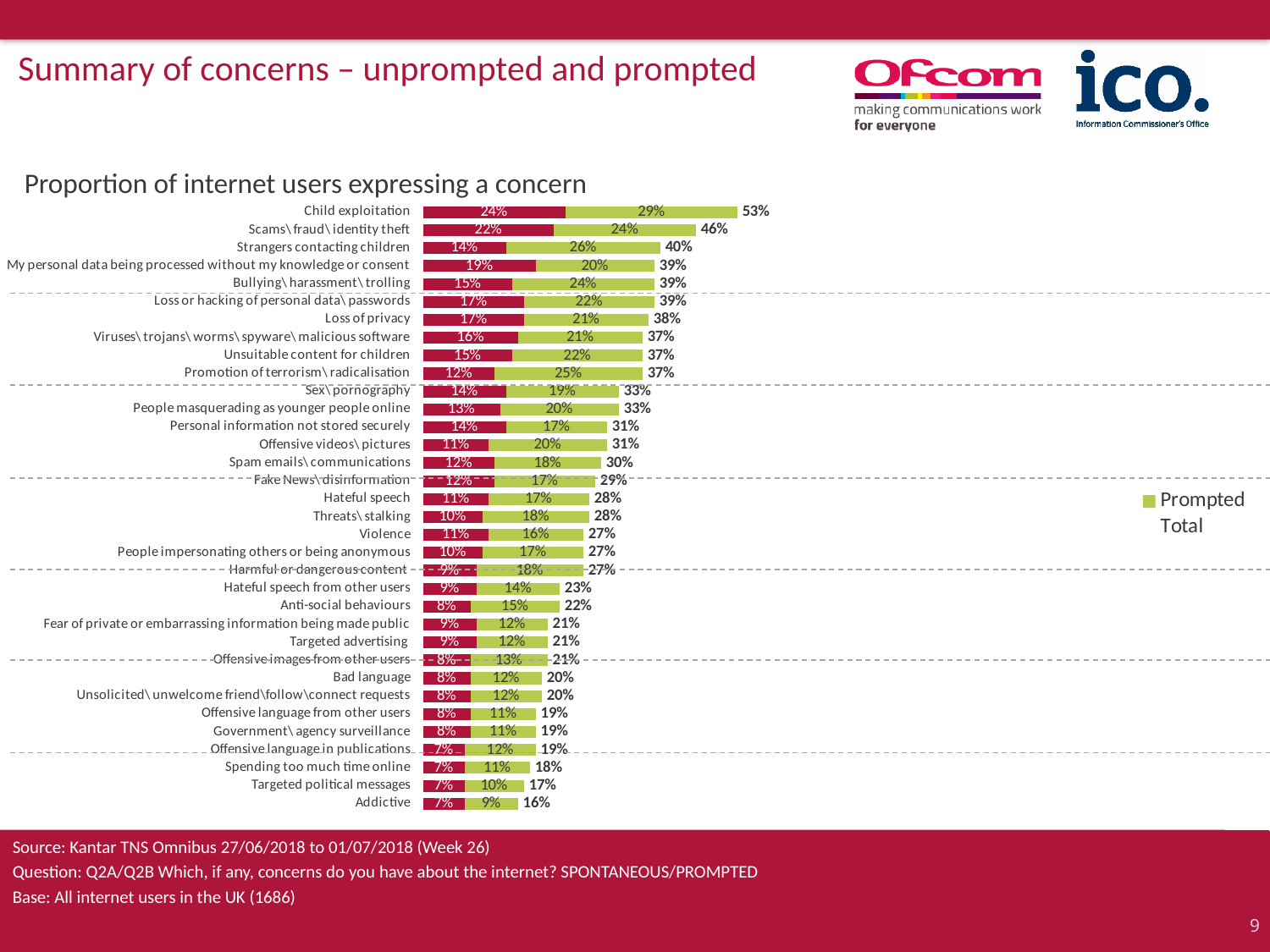
Which concern has the highest total proportion of internet users expressing it? Child exploitation What is the title of the chart? Proportion of internet users expressing a concern Which concern has the lowest total proportion of internet users expressing it? Addictive What is the value of the red (unprompted) segment for Child exploitation? 24% What is the Prompted (green) value for Strangers contacting children? 26% What is the total percentage for Scams\fraud\identity theft? 46% What is the total percentage for Targeted political messages? 17% What is the difference between the total for Child exploitation and the total for Scams\fraud\identity theft? 7 percentage points How many concerns (categories) are listed in the chart? 34 How many entries does the chart legend list? 2 Which has a higher total: Bullying\harassment\trolling or Sex\pornography? Bullying\harassment\trolling What kind of chart is shown on the slide? bar chart